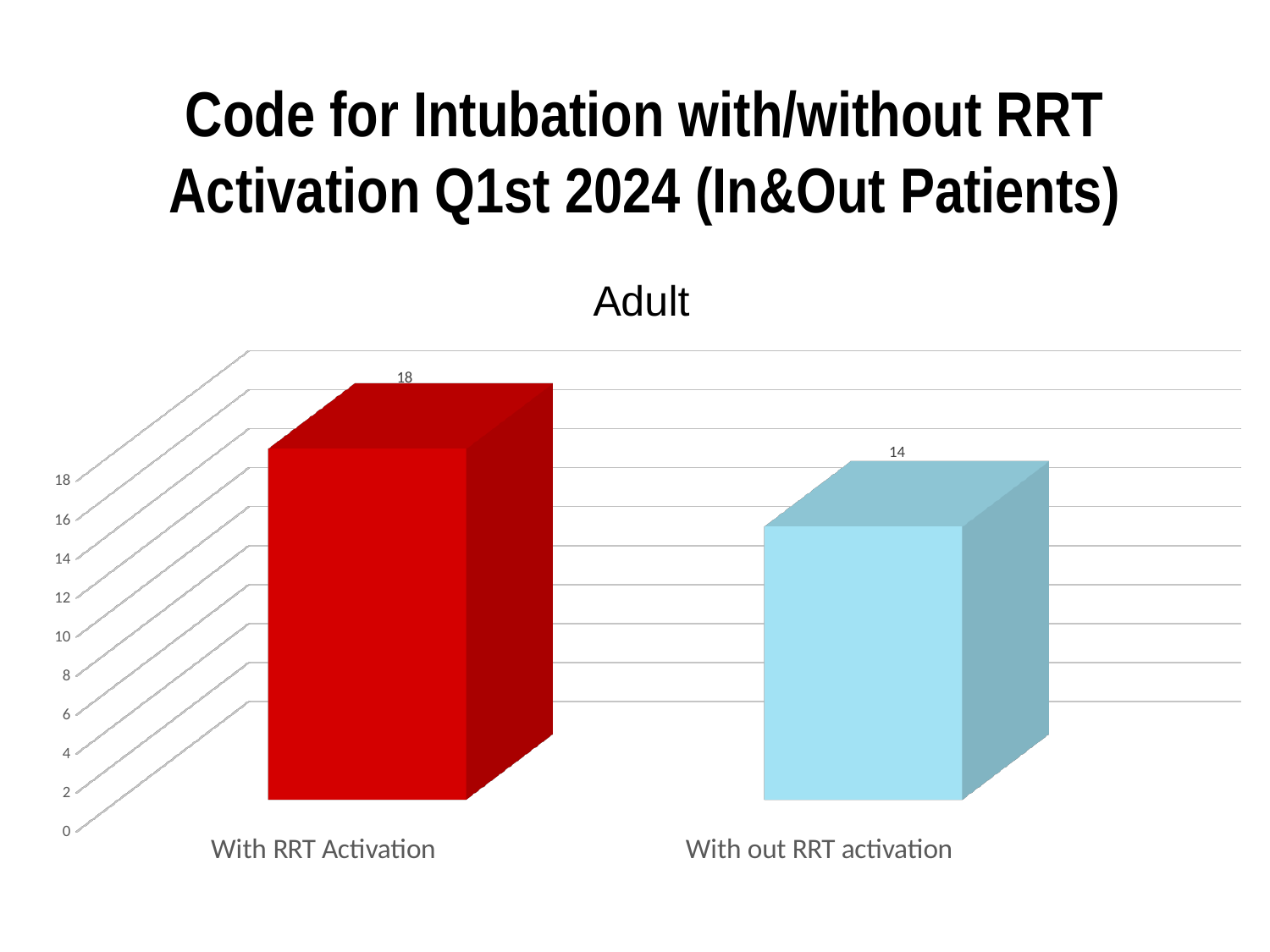
What is the value for With out RRT activation? 14 Which is larger, the value for With RRT Activation or With out RRT activation? With RRT Activation Is the value for With out RRT activation greater or less than 16? less How many categories are shown on the chart? 2 Which category has the highest value? With RRT Activation What is the total of the two values shown on the chart? 32 What kind of chart is shown on the slide? bar chart What colour is the bar for With RRT Activation? red What is the value for With RRT Activation? 18 Which category has the lowest value? With out RRT activation What is the difference between the values for With RRT Activation and With out RRT activation? 4 What is the title of the chart? Adult